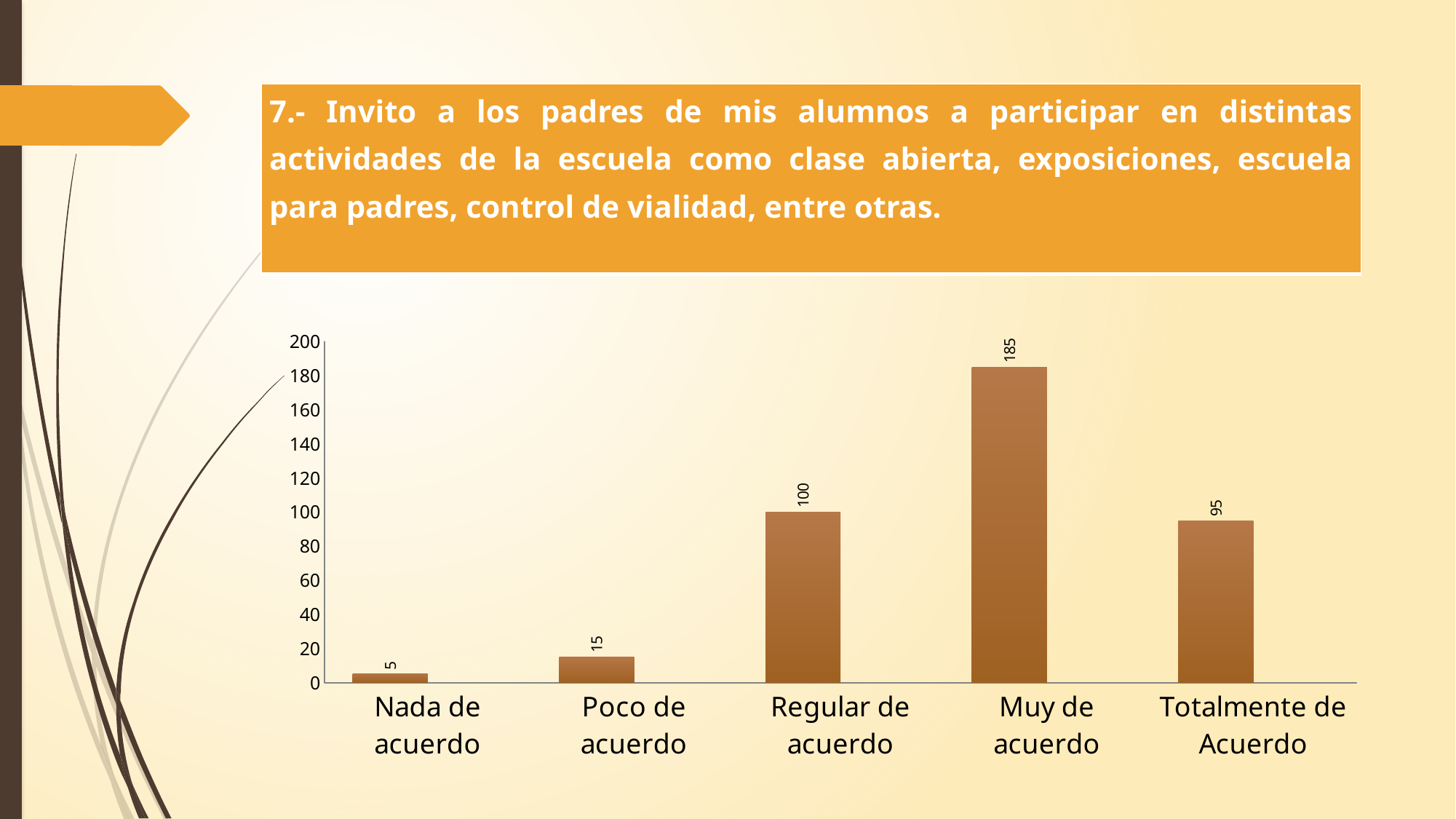
Which category has the highest value? Muy de acuerdo What kind of chart is shown on the slide? bar chart Which category has the lowest value? Nada de acuerdo How many categories are shown on the x axis? 5 What is the value for "Regular de acuerdo"? 100 Is the value for "Muy de acuerdo" greater or less than 160? greater What is the value for "Nada de acuerdo"? 5 What is the difference between the values for "Poco de acuerdo" and "Nada de acuerdo"? 10 Which is larger, the value for "Regular de acuerdo" or the value for "Totalmente de Acuerdo"? Regular de acuerdo What is the value for "Muy de acuerdo"? 185 What is the difference between the values for "Muy de acuerdo" and "Regular de acuerdo"? 85 What is the value for "Totalmente de Acuerdo"? 95